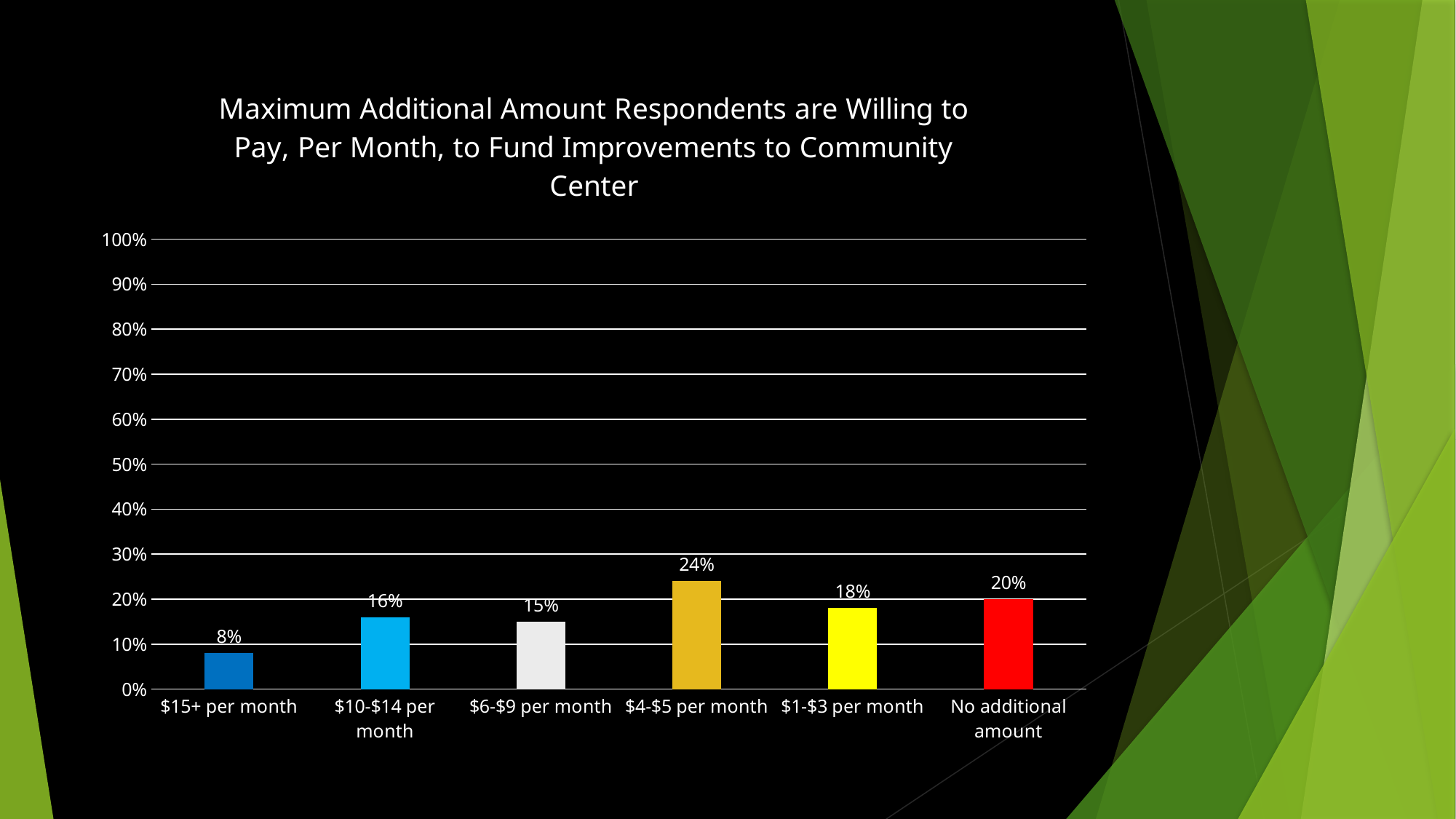
What kind of chart is shown on the slide? bar chart Which is larger: the value for $10-$14 per month or the value for $6-$9 per month? $10-$14 per month What percentage of respondents chose $4-$5 per month? 24% What is the difference between the $4-$5 per month value and the $15+ per month value? 16% What colour is the bar for $1-$3 per month? yellow Is the value for 'No additional amount' greater or less than 30%? less What is the value for $1-$3 per month? 18% Which category has the lowest percentage of respondents? $15+ per month What percentage of respondents are willing to pay $15+ per month? 8% How many categories are shown on the x axis? 6 Which category has the highest percentage of respondents? $4-$5 per month What percentage of respondents chose 'No additional amount'? 20%